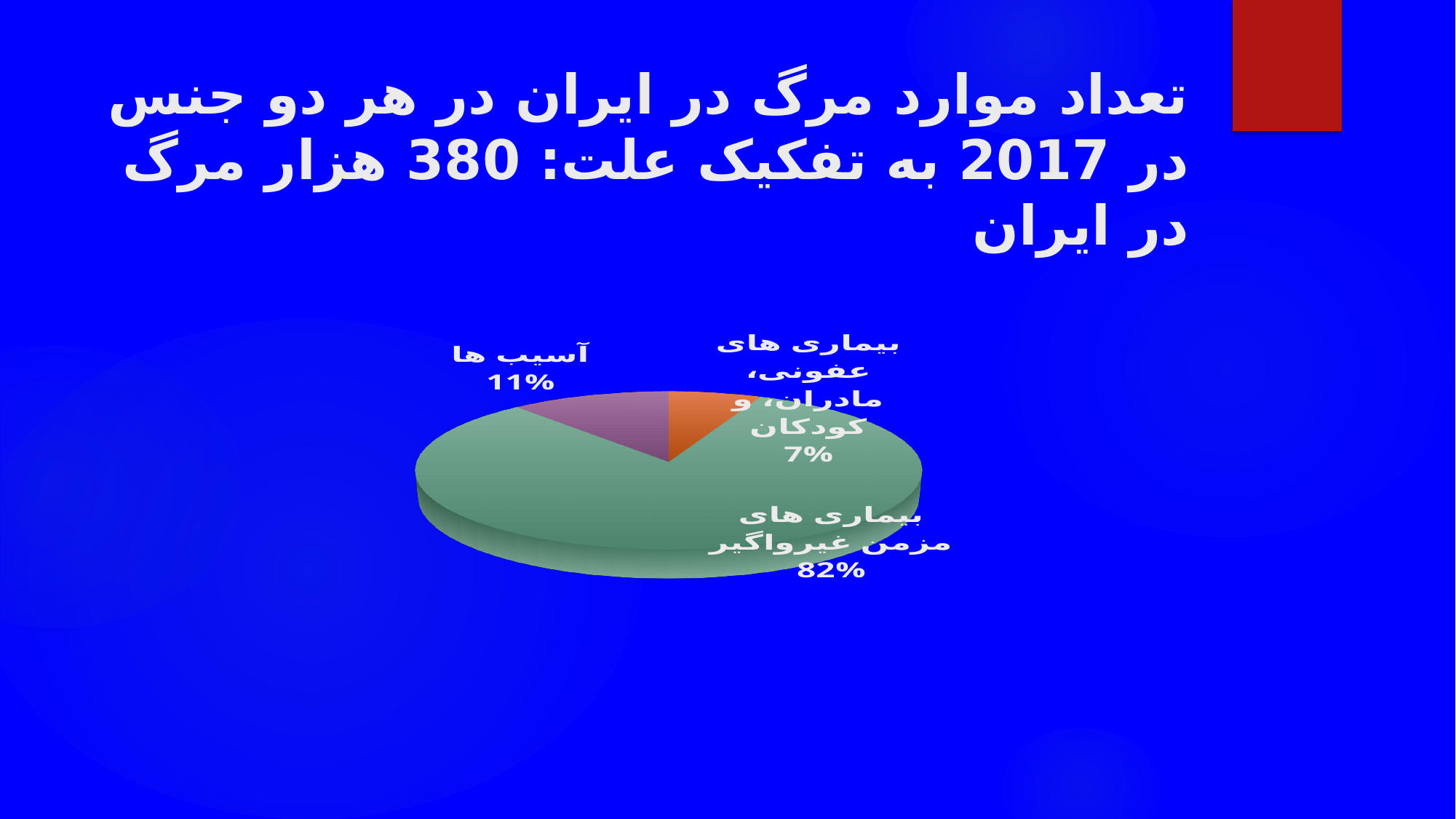
Which category has the smallest slice of the pie? بیماری های عفونی، مادران، و کودکان What kind of chart is shown on the slide? pie chart Which category has the largest slice of the pie? بیماری های مزمن غیرواگیر What share of the pie is labelled "بیماری های مزمن غیرواگیر"? 82% How many slices does the pie chart have? 3 Which is larger: the slice for "آسیب ها" or the slice for "بیماری های عفونی، مادران، و کودکان"? آسیب ها What colour is the slice for "آسیب ها"? purple What is the difference in percentage points between "بیماری های مزمن غیرواگیر" and "آسیب ها"? 71 What is the difference in percentage points between "آسیب ها" and "بیماری های عفونی، مادران، و کودکان"? 4 What share of the pie is labelled "بیماری های عفونی، مادران، و کودکان"? 7% What colour is the slice for "بیماری های مزمن غیرواگیر"? green What share of the pie is labelled "آسیب ها"? 11%